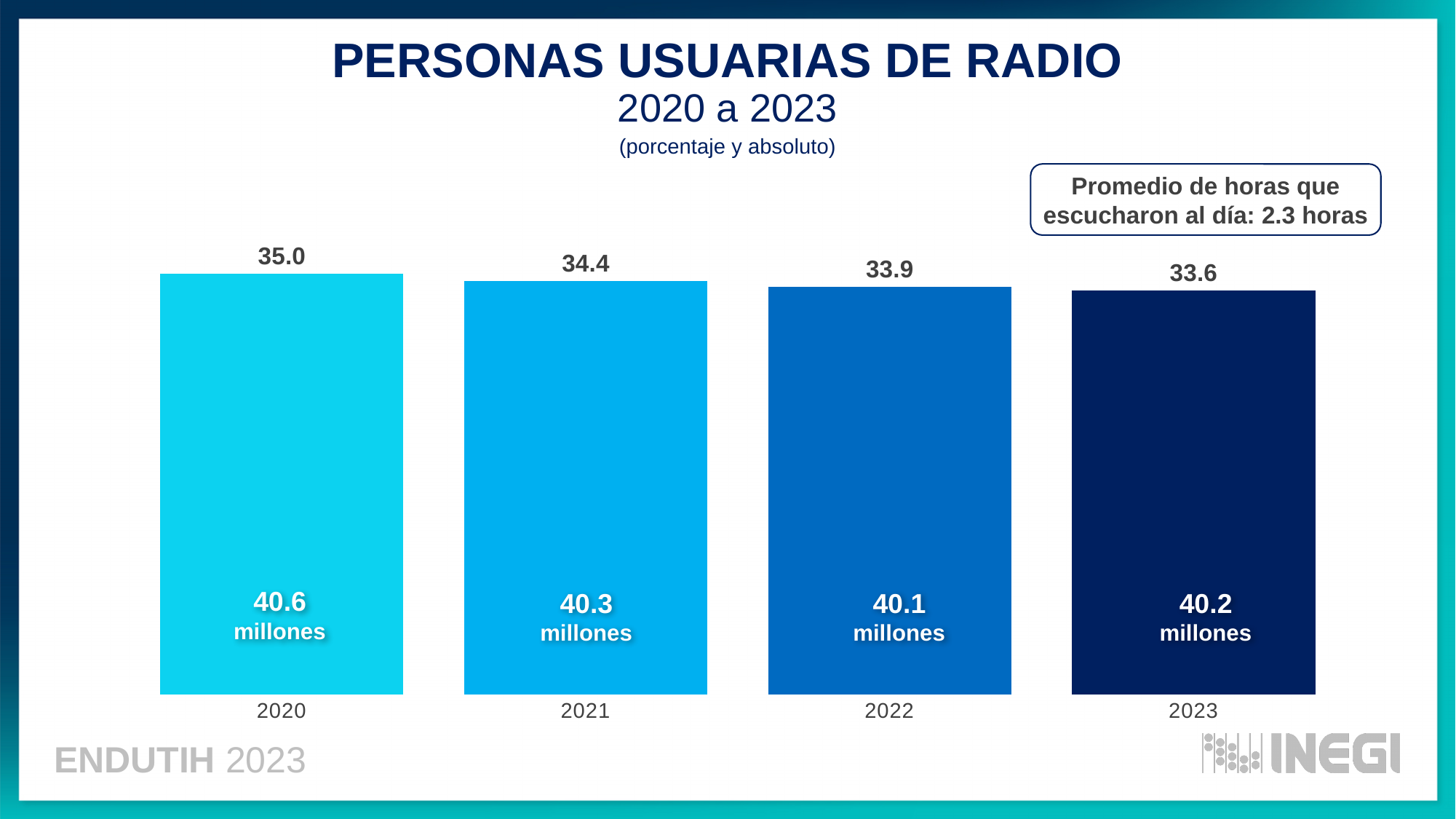
Which year has the lowest percentage value? 2023 Do the percentage values rise or fall from 2020 to 2023? Fall What is the percentage value shown above the bar for 2023? 33.6 According to the text box on the slide, what was the average number of hours listened per day? 2.3 horas What is the percentage value shown above the bar for 2020? 35.0 How many millions of radio users are shown inside the bar for 2021? 40.3 millones What is the difference between the percentage values for 2020 and 2023? 1.4 Which year has the highest percentage value? 2020 How many years (bars) are shown in the chart? 4 How many millions of radio users are shown inside the bar for 2022? 40.1 millones Which is larger, the percentage value for 2021 or for 2022? 2021 What kind of chart is shown on the slide? Bar chart